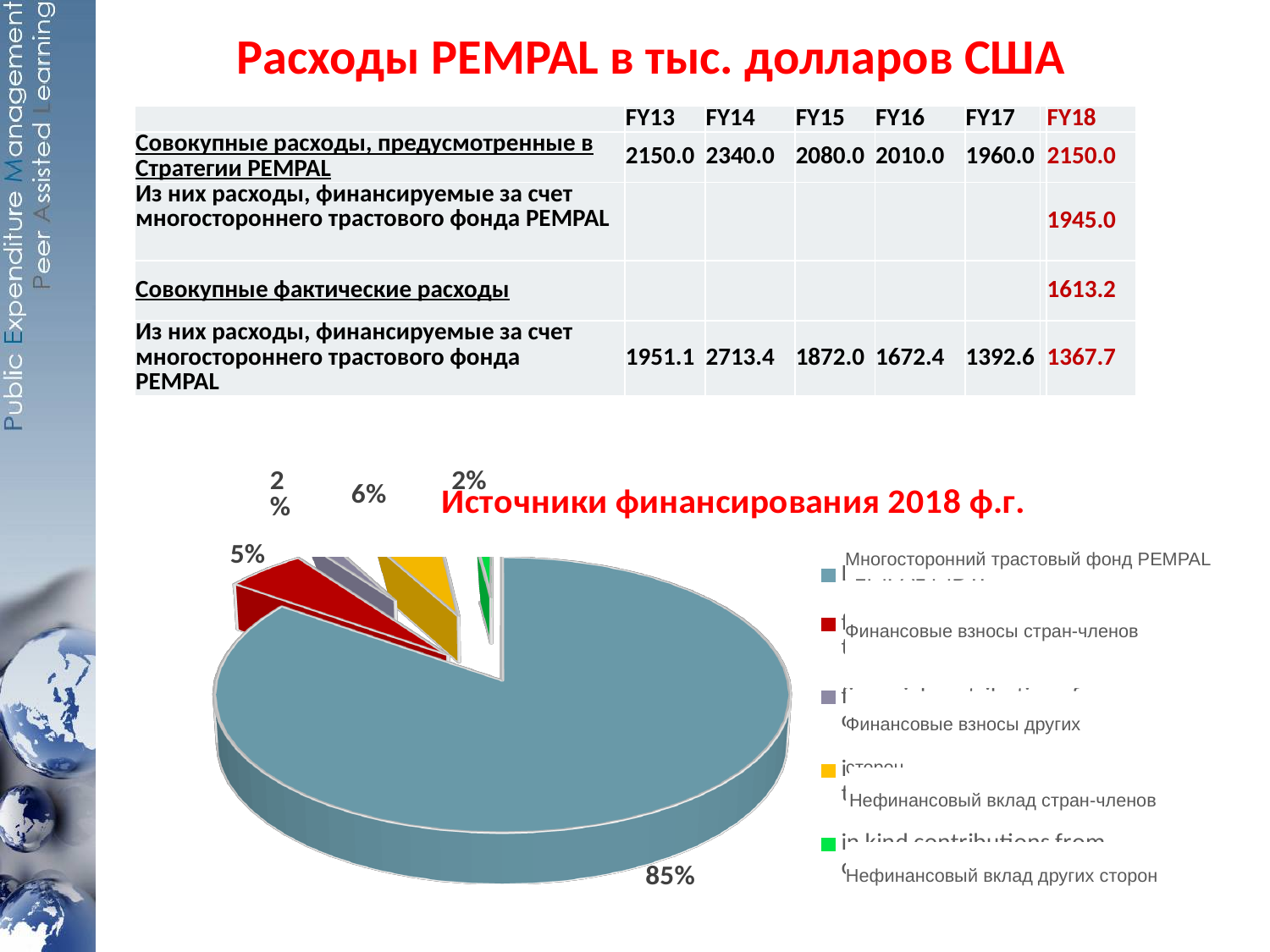
In the pie chart 'Источники финансирования 2018 ф.г.', what share does 'Финансовые взносы стран-членов' have? 5% What kind of chart is shown under the title 'Источники финансирования 2018 ф.г.'? pie chart In the pie chart 'Источники финансирования 2018 ф.г.', which is larger: 'Нефинансовый вклад стран-членов' or 'Финансовые взносы стран-членов'? Нефинансовый вклад стран-членов In the pie chart 'Источники финансирования 2018 ф.г.', how many entries does the legend list? 5 In the pie chart 'Источники финансирования 2018 ф.г.', what share does 'Нефинансовый вклад других сторон' have? 2% In the pie chart 'Источники финансирования 2018 ф.г.', which source has the largest share? Многосторонний трастовый фонд PEMPAL In the pie chart 'Источники финансирования 2018 ф.г.', how many slices are there? 5 In the pie chart 'Источники финансирования 2018 ф.г.', what share does 'Нефинансовый вклад стран-членов' have? 6% In the pie chart 'Источники финансирования 2018 ф.г.', what is the difference between the share of 'Многосторонний трастовый фонд PEMPAL' and the share of 'Нефинансовый вклад стран-членов'? 79% In the pie chart 'Источники финансирования 2018 ф.г.', what colour is the slice for 'Финансовые взносы стран-членов'? red